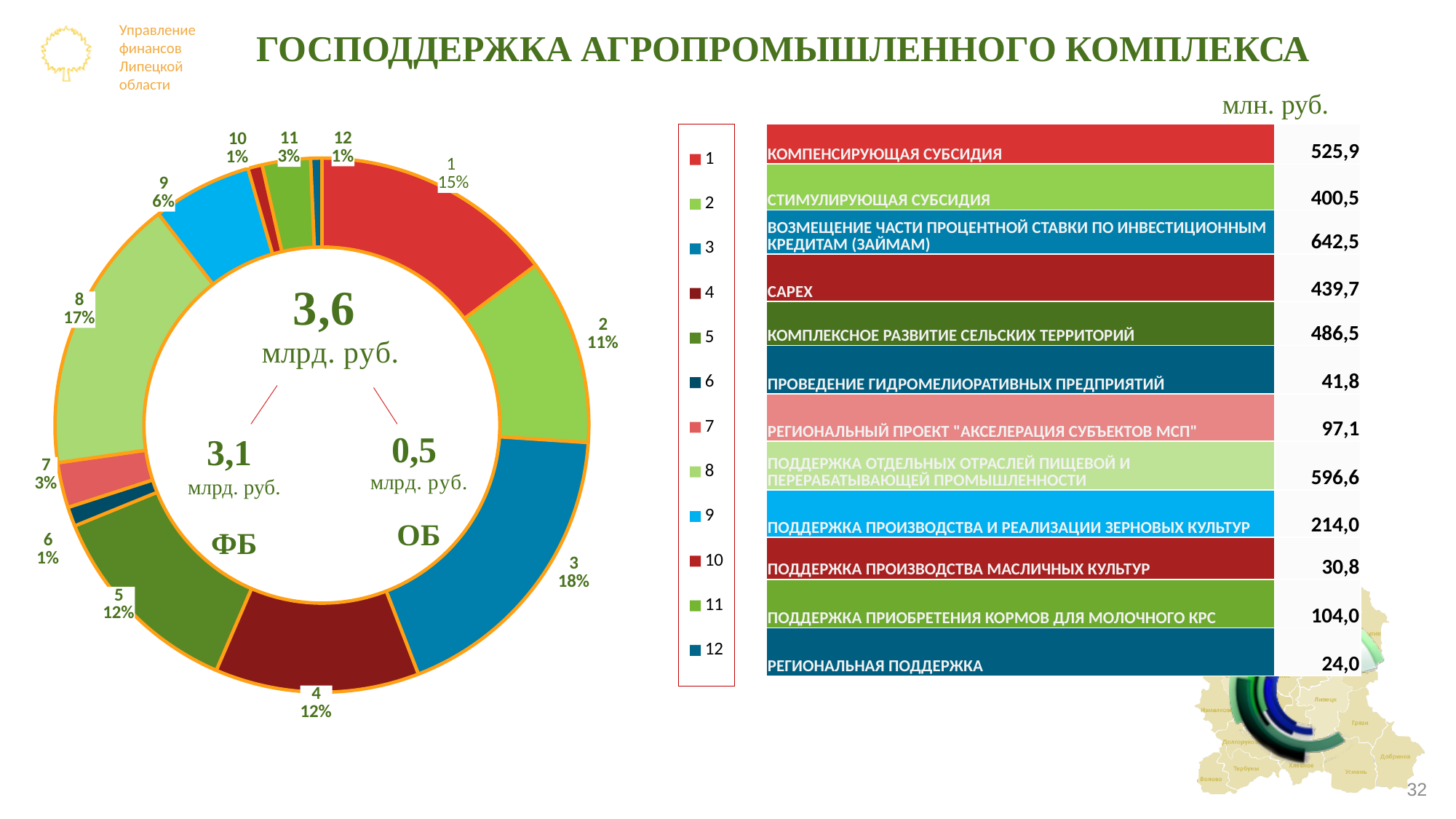
What percentage is shown for segment 5 in the doughnut chart? 12% What total value is shown in the centre of the doughnut chart? 3,6 млрд. руб. By how many percentage points does segment 3 exceed segment 2 in the doughnut chart? 7 What share of the doughnut chart does segment 3 represent? 18% Which segment has the larger share in the doughnut chart, segment 1 or segment 2? 1 What share of the doughnut chart does segment 8 represent? 17% What value is shown for ОБ in the centre of the doughnut chart? 0,5 млрд. руб. Which segment of the doughnut chart has the largest share? 3 What value is shown for ФБ in the centre of the doughnut chart? 3,1 млрд. руб. What kind of chart is shown on the left of the slide? pie chart (doughnut) How many entries does the legend of the doughnut chart list? 12 How many segments does the doughnut chart have? 12